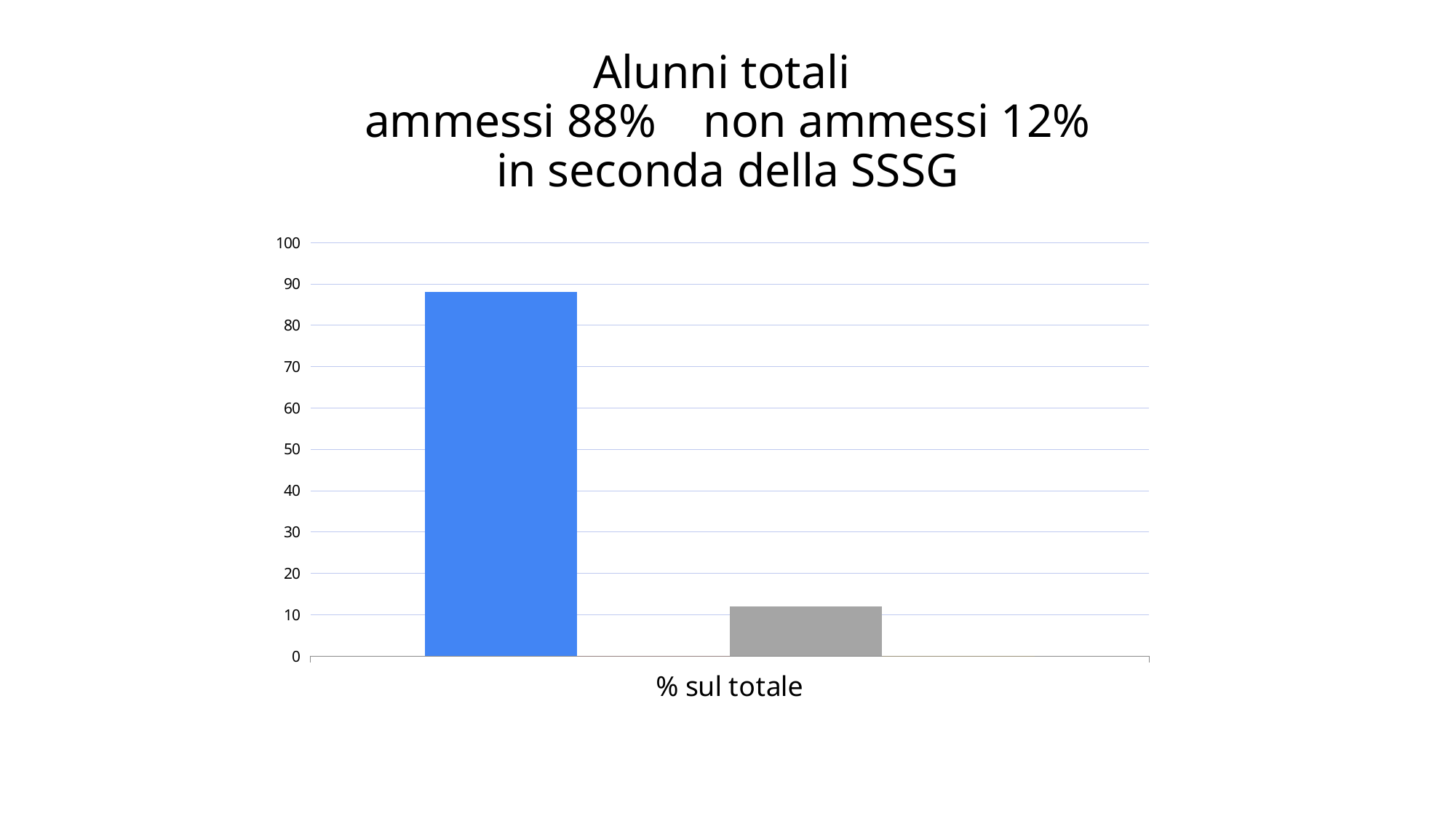
What is the difference in percentage points between 'ammessi' (88%) and 'non ammessi' (12%)? 76 Which group has the lower value, 'ammessi' or 'non ammessi'? non ammessi According to the slide, what percentage of students were 'non ammessi'? 12% Is the value of the grey bar greater or less than 20? less How many bars are plotted in the chart? 2 Which group has the higher value, 'ammessi' or 'non ammessi'? ammessi What do the 'ammessi' and 'non ammessi' percentages add up to? 100% What kind of chart is shown on the slide? bar chart What is the category label shown on the x axis of the chart? % sul totale Is the value of the blue bar greater or less than 80? greater According to the slide, what percentage of students were 'ammessi'? 88% Which bar is taller, the blue bar or the grey bar? the blue bar